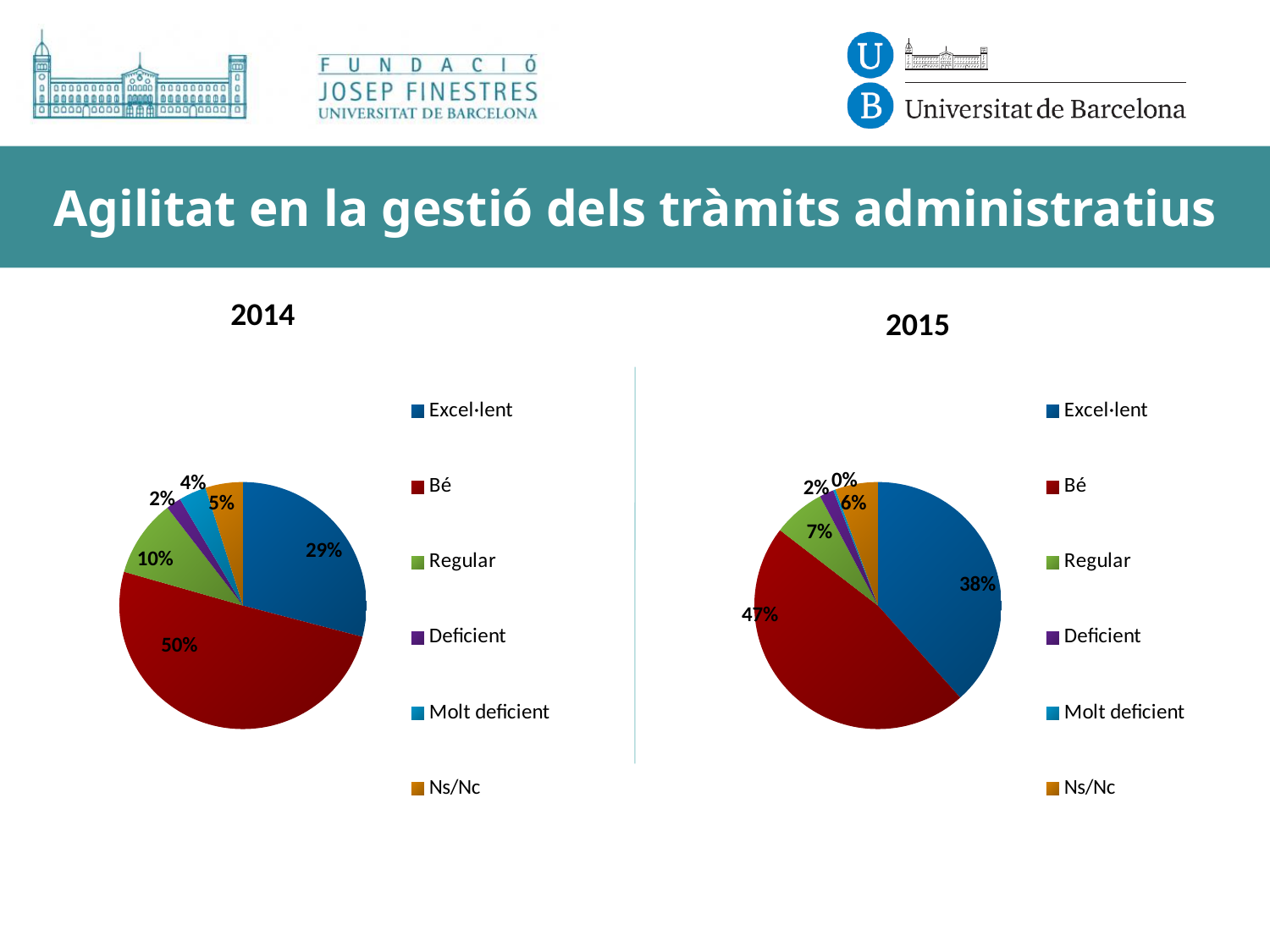
What is the difference between the Excel·lent share in the 2015 chart and the Excel·lent share in the 2014 chart? 9% In the 2014 chart, what percentage is shown for Regular? 10% In the 2015 chart, which category has the smallest share? Molt deficient In the 2014 chart, which category has the largest share? Bé In the 2015 chart, what percentage is shown for Excel·lent? 38% In the 2014 chart, what percentage is shown for Bé? 50% In the 2014 chart, which category has the smallest share? Deficient What type of chart is used for the 2015 data? Pie chart How many categories does the legend of the 2014 chart list? 6 In the 2015 chart, what percentage is shown for Molt deficient? 0% In the 2015 chart, what percentage is shown for Ns/Nc? 6% In the 2015 chart, which is larger: the share for Regular or the share for Ns/Nc? Regular